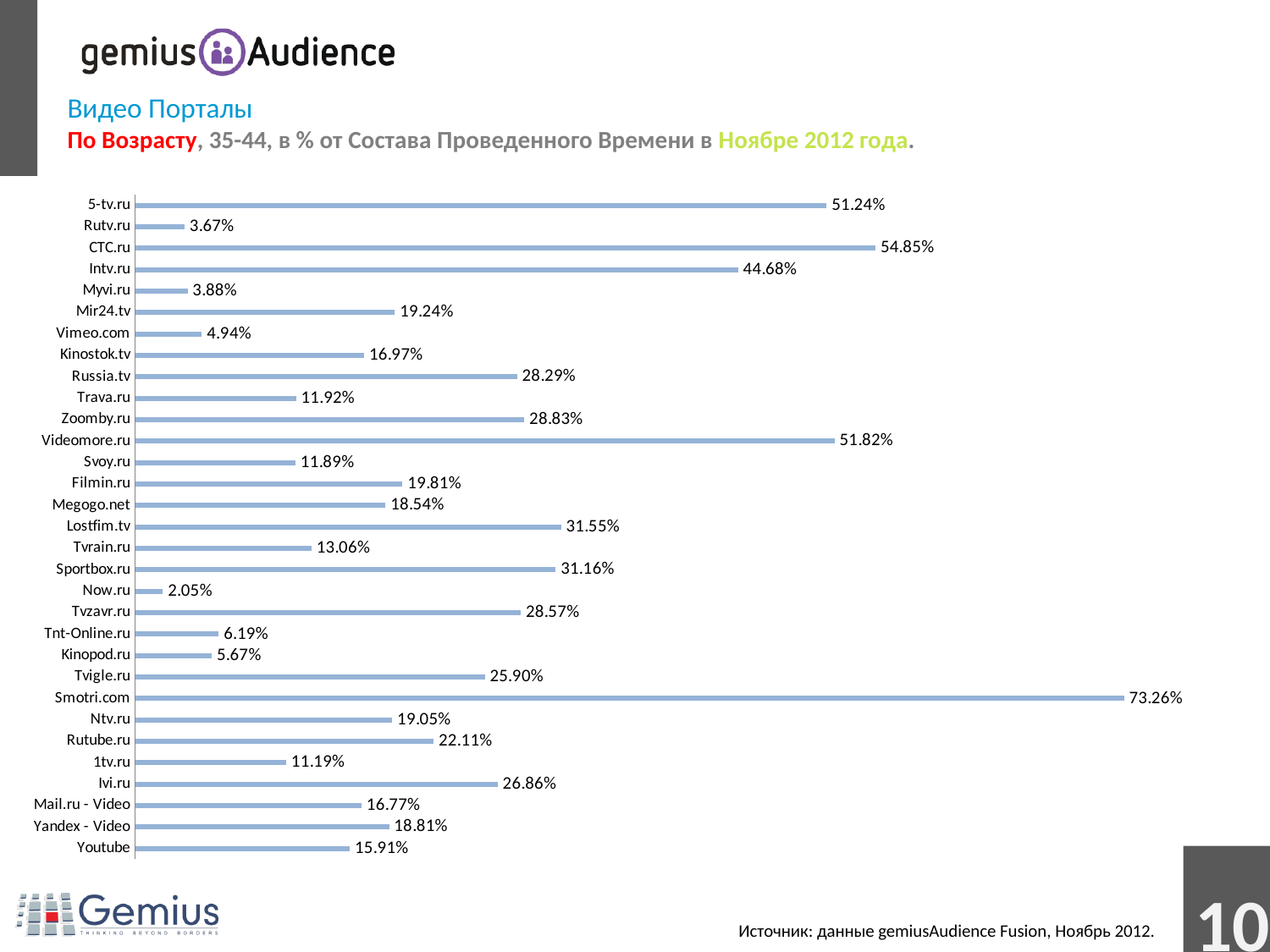
How many video portals are shown in the chart? 31 Which is larger, the value for Tvigle.ru or the value for Zoomby.ru? Zoomby.ru What is the value for Youtube? 15.91% Which is larger, the value for Intv.ru or the value for Lostfim.tv? Intv.ru Which video portal has the lowest value? Now.ru Which age group does the chart cover, according to the subtitle? 35-44 What is the difference between the values for Ivi.ru and Rutube.ru? 4.75% What is the value for Videomore.ru? 51.82% What is the difference between the values for CTC.ru and 5-tv.ru? 3.61% What is the value for Smotri.com? 73.26% Which video portal has the highest value? Smotri.com What kind of chart is shown on the slide? Bar chart